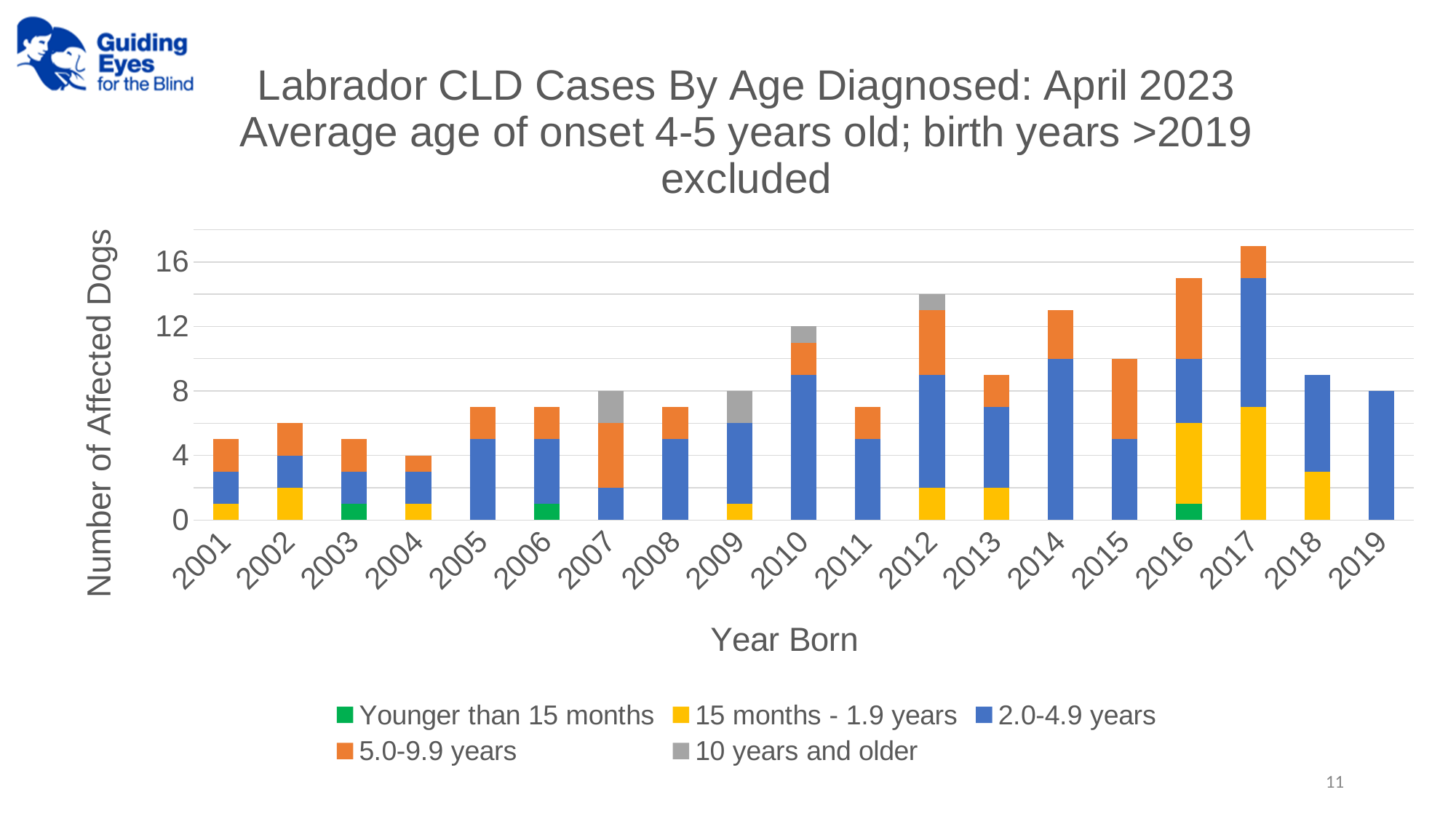
What is the total number of affected dogs for birth year 2019? 8 Is the total number of affected dogs for birth year 2016 greater or less than 12? greater Which birth year has the lowest total number of affected dogs? 2004 Which birth year has more affected dogs in total, 2010 or 2011? 2010 What is the title of the y axis? Number of Affected Dogs How many age groups does the legend list? 5 Which age group is shown in grey in the legend? 10 years and older Is the total number of affected dogs for birth year 2017 greater or less than 16? greater How many birth years are shown on the x axis? 19 Is the total number of affected dogs for birth year 2001 greater or less than 4? greater What kind of chart is shown on the slide? Stacked bar chart Which birth year has the highest total number of affected dogs? 2017